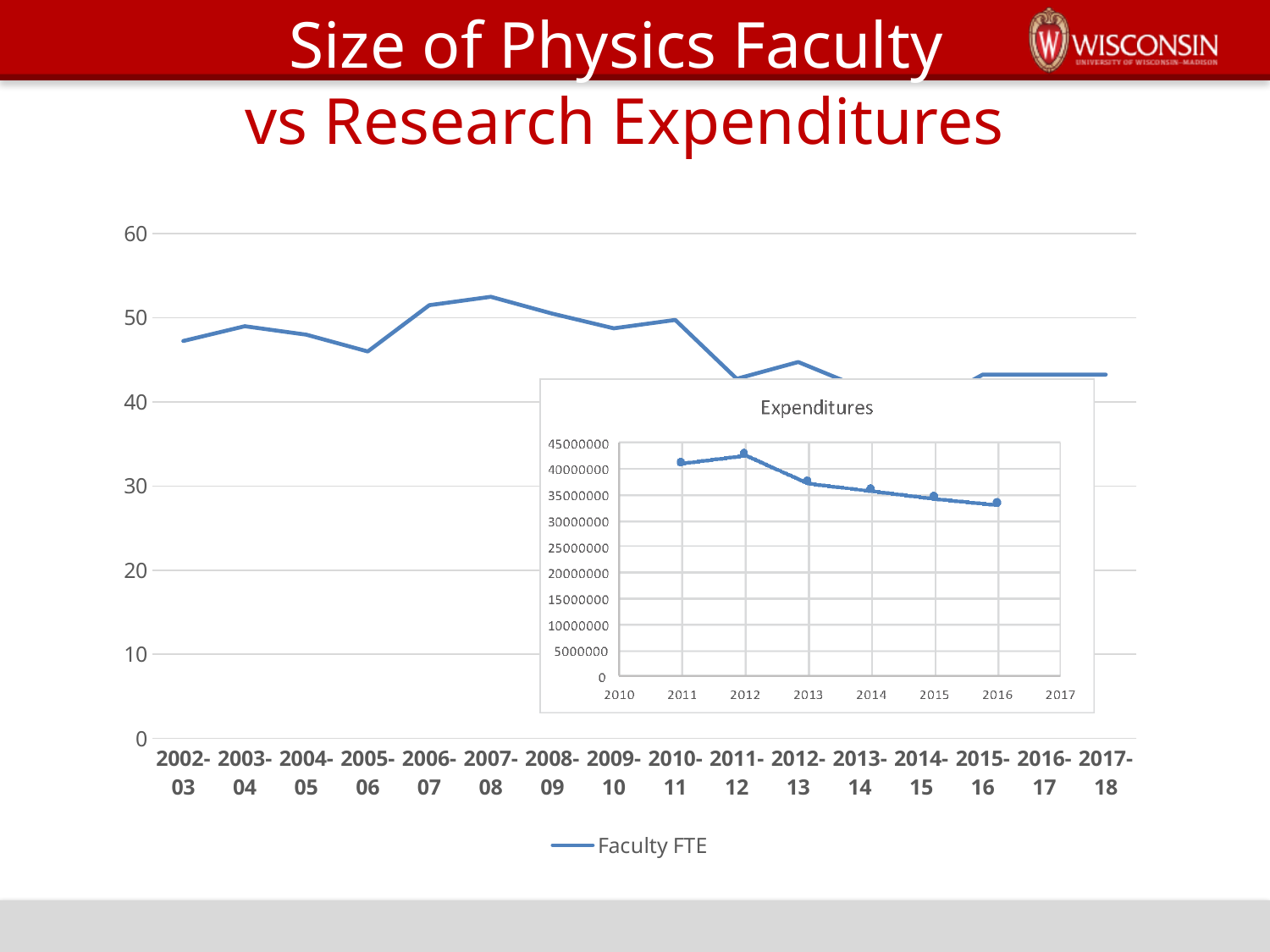
In the inset Expenditures chart, which year has the highest value? 2012 In the inset Expenditures chart, is the value for 2011 greater or less than 40000000? greater What is the title of the inset chart? Expenditures In the inset Expenditures chart, which year has the lowest value? 2016 In the large Faculty FTE chart, how many academic years are shown on the x axis? 16 How many series does the legend of the large Faculty FTE chart list? 1 In the large Faculty FTE chart, is the value for 2007-08 greater or less than 50? greater In the large Faculty FTE chart, which is larger, the value for 2007-08 or the value for 2011-12? 2007-08 In the inset Expenditures chart, do the values generally rise or fall from 2012 to 2016? fall In the large Faculty FTE chart, which academic year has the highest value? 2007-08 What kind of chart is the large chart with the Faculty FTE legend? line chart In the large Faculty FTE chart, is the value for 2011-12 greater or less than 50? less